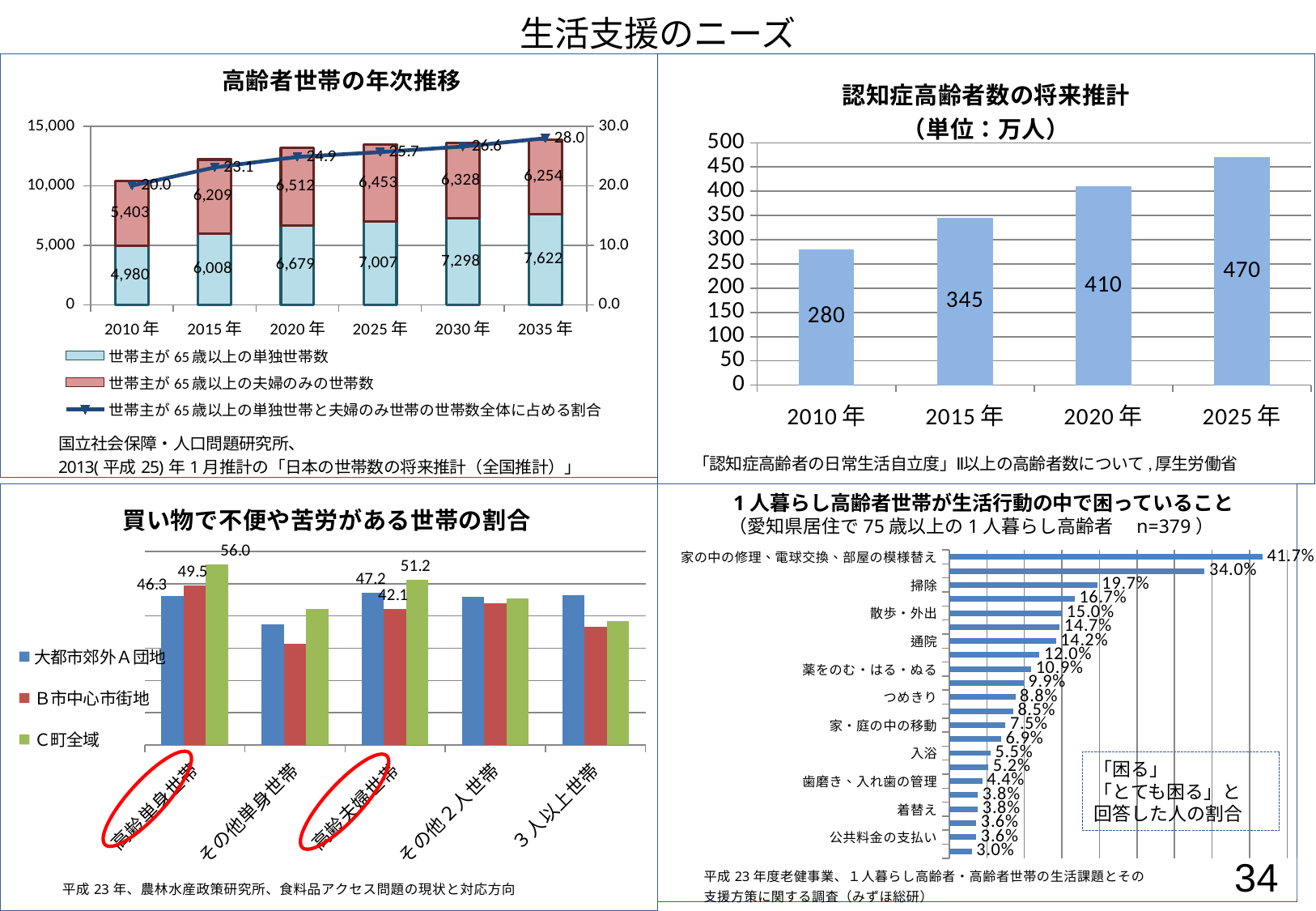
In the 高齢者世帯の年次推移 chart (top left), what is the value of the line series for 2020年? 24.9 In the 認知症高齢者数の将来推計 chart (top right), what is the value for 2025年? 470 In the 認知症高齢者数の将来推計 chart (top right), how many years are plotted? 4 What kind of chart is the 1人暮らし高齢者世帯が生活行動の中で困っていること chart (bottom right)? bar chart In the 高齢者世帯の年次推移 chart (top left), what is the total of the stacked bar for 2010年? 10,383 In the 買い物で不便や苦労がある世帯の割合 chart (bottom left), what is the value for C町全域 in the 高齢単身世帯 category? 56.0 In the 1人暮らし高齢者世帯が生活行動の中で困っていること chart (bottom right), what is the highest value shown? 41.7% In the 認知症高齢者数の将来推計 chart (top right), do the values rise or fall from 2010年 to 2025年? rise In the 高齢者世帯の年次推移 chart (top left), what is the value of 世帯主が65歳以上の単独世帯数 for 2035年? 7,622 In the 高齢者世帯の年次推移 chart (top left), how many series does the legend list? 3 In the 買い物で不便や苦労がある世帯の割合 chart (bottom left), which is larger for 高齢夫婦世帯: 大都市郊外A団地 or B市中心市街地? 大都市郊外A団地 In the 認知症高齢者数の将来推計 chart (top right), what is the difference between the 2025年 and 2010年 values? 190